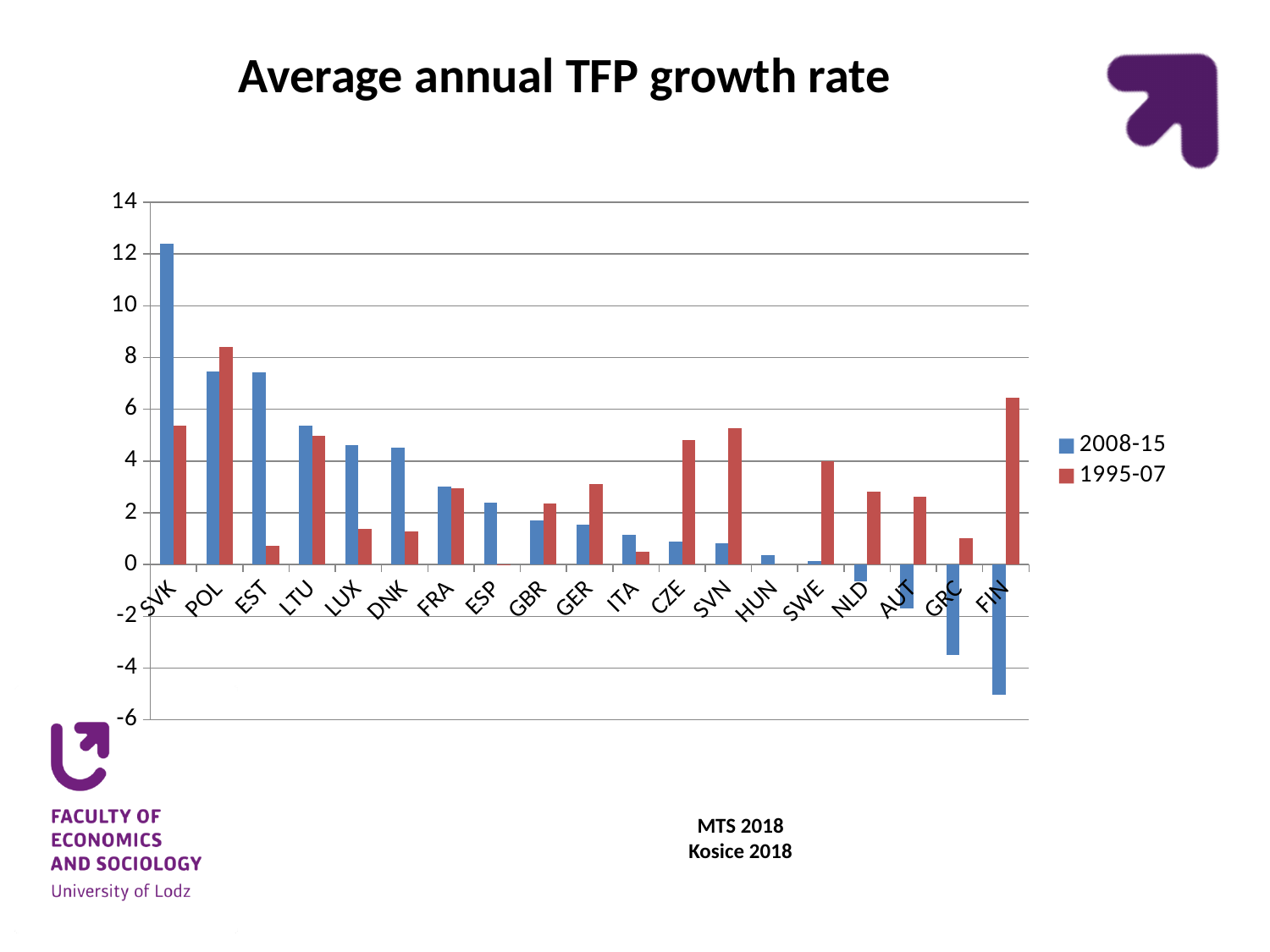
For CZE, which series has the larger value, 2008-15 or 1995-07? 1995-07 Which country has the lowest value for the 2008-15 series? FIN Which country has the highest value for the 1995-07 series? POL Which country has the highest value for the 2008-15 series? SVK For EST, which series has the larger value, 2008-15 or 1995-07? 2008-15 How many series does the legend list? 2 What kind of chart is shown on the slide? bar chart Do the 2008-15 values generally rise or fall from left to right along the x axis? fall Is the 1995-07 value for CZE greater or less than 4? greater Is the 2008-15 value for SVK greater or less than 10? greater How many countries are shown on the x axis? 19 Is the 2008-15 value for GRC greater or less than -2? less